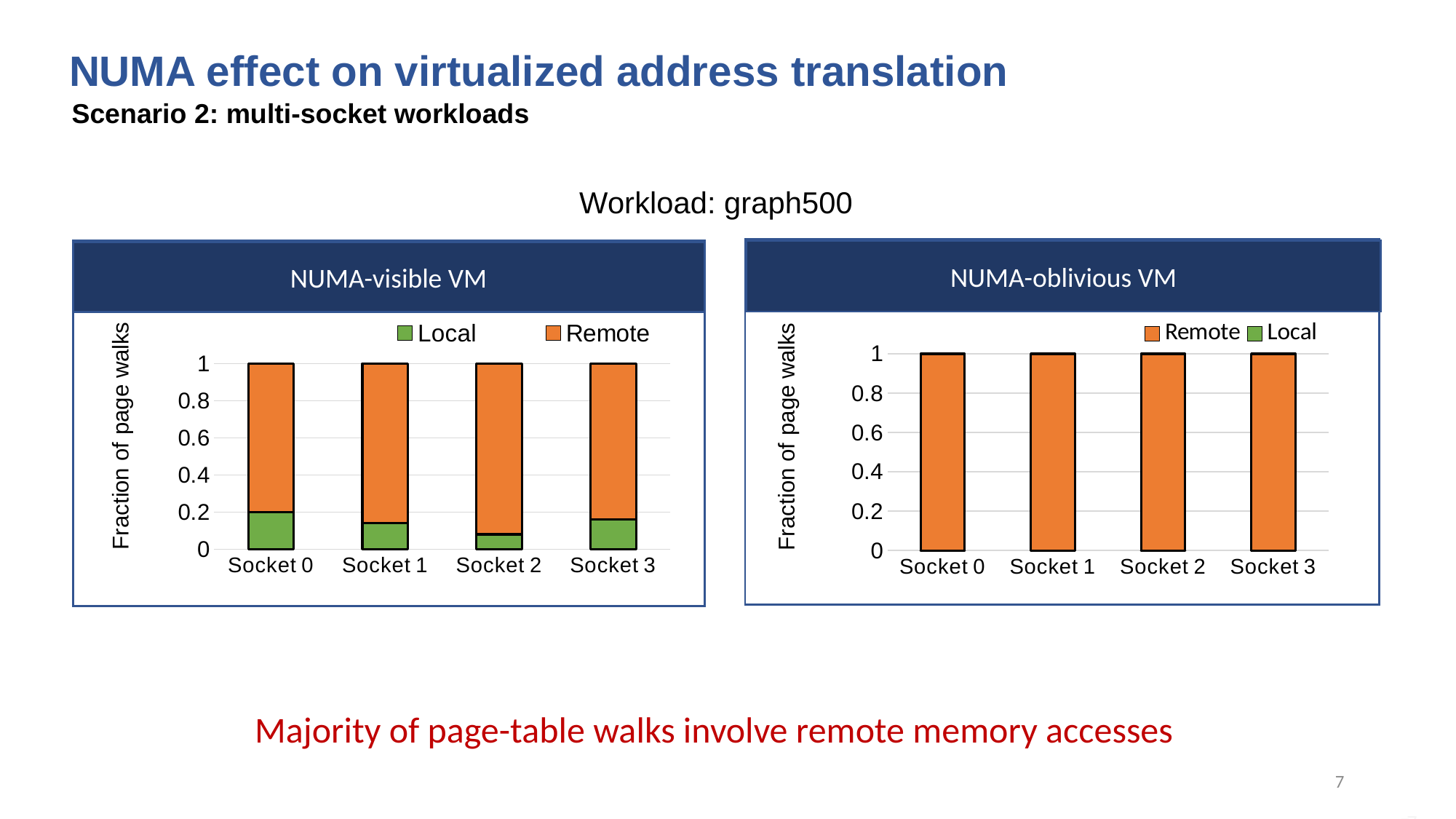
What is the y-axis label of the NUMA-oblivious VM chart? Fraction of page walks In the NUMA-visible VM chart, which is larger, the Local fraction for Socket 1 or for Socket 2? Socket 1 What kind of chart is the NUMA-visible VM chart? stacked bar chart In the NUMA-oblivious VM chart, is the Remote fraction for Socket 3 greater or less than 0.8? greater In the NUMA-visible VM chart, which socket has the lowest Local fraction of page walks? Socket 2 In the NUMA-visible VM chart, is the Local fraction for Socket 2 greater or less than 0.2? less In the NUMA-visible VM chart, what is the total height of the stacked bar for Socket 0? 1 How many series does the legend of the NUMA-visible VM chart list? 2 How many sockets are shown on the x axis of the NUMA-oblivious VM chart? 4 In the NUMA-visible VM chart, is the Local fraction for Socket 0 greater or less than 0.4? less In the NUMA-oblivious VM chart, what is the total height of the stacked bar for Socket 1? 1 Which colour represents the Remote series in the NUMA-visible VM chart? orange